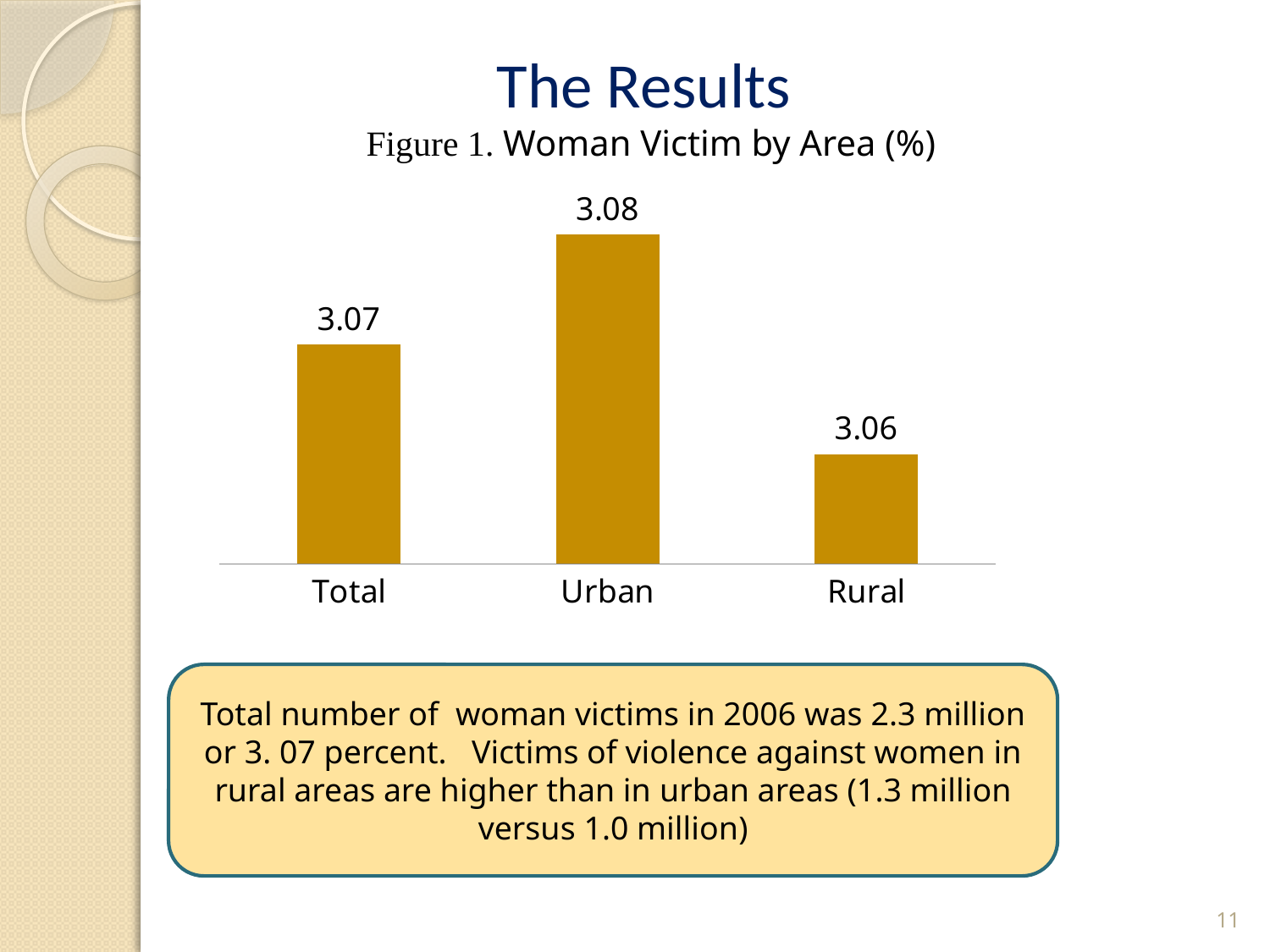
What is the difference between the Urban and Rural values? 0.02 How many categories are shown in the chart? 3 What is the value for Urban in the chart? 3.08 What is the title of the chart? Figure 1. Woman Victim by Area (%) Which category has the highest value? Urban What is the value for Total in the chart? 3.07 Which is larger, the value for Urban or the value for Rural? Urban What is the value for Rural in the chart? 3.06 Which category has the lowest value? Rural What colour are the bars in the chart? Gold What kind of chart is shown on the slide? Bar chart What is the difference between the Total and Rural values? 0.01